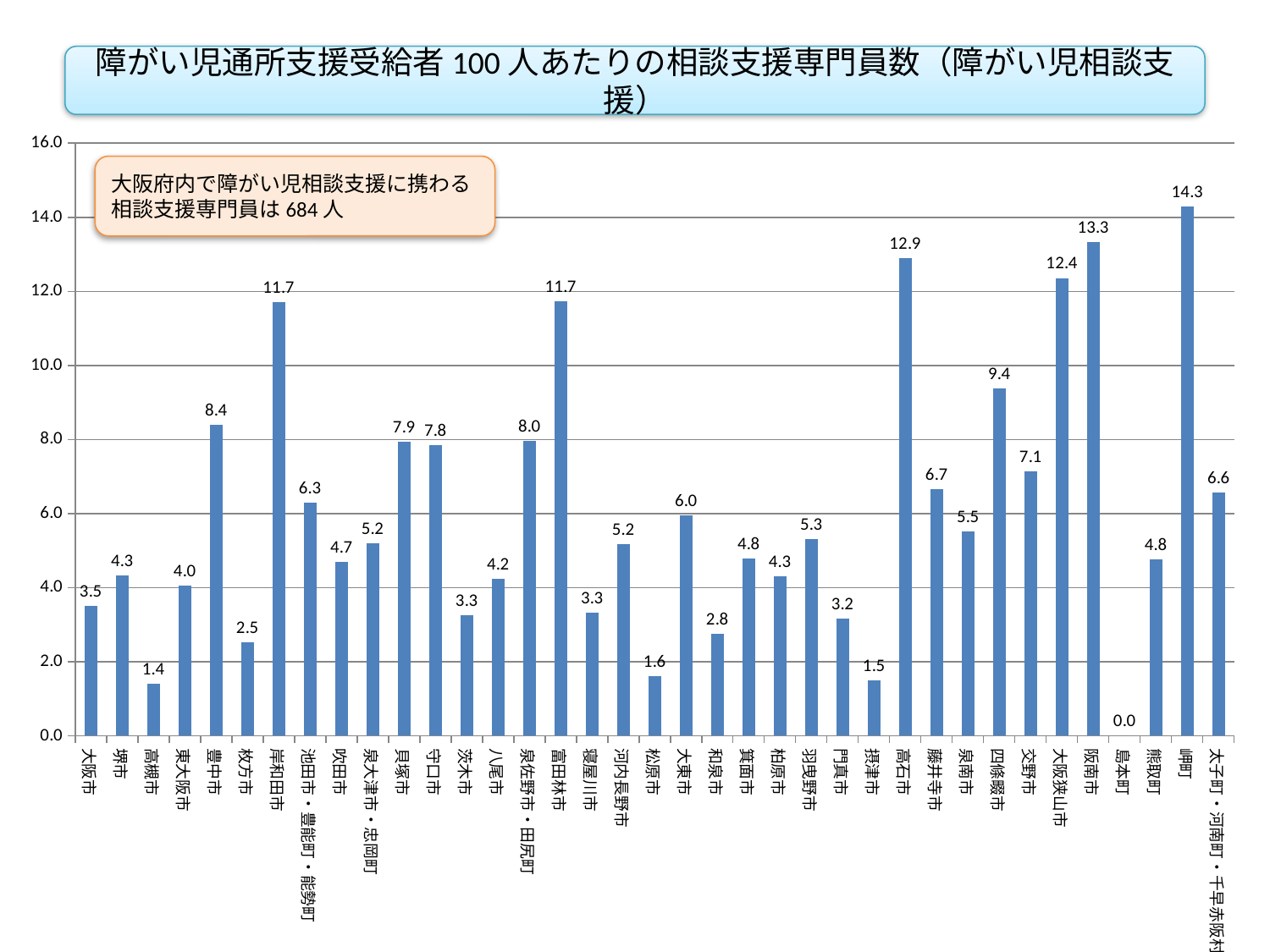
Is the value for 岸和田市 greater or less than 10.0? greater Which category has the highest value? 岬町 Which is larger, the value for 豊中市 or the value for 四條畷市? 四條畷市 What is the value for 岬町? 14.3 What is the value for 高石市? 12.9 Which category has the lowest value? 島本町 What is the value for 島本町? 0.0 According to the text box on the chart, how many 相談支援専門員 are engaged in 障がい児相談支援 in 大阪府? 684人 What kind of chart is shown on the slide? bar chart How many categories are shown on the x axis? 37 What is the value for 大阪市? 3.5 What is the difference between the values for 阪南市 and 大阪狭山市? 0.9